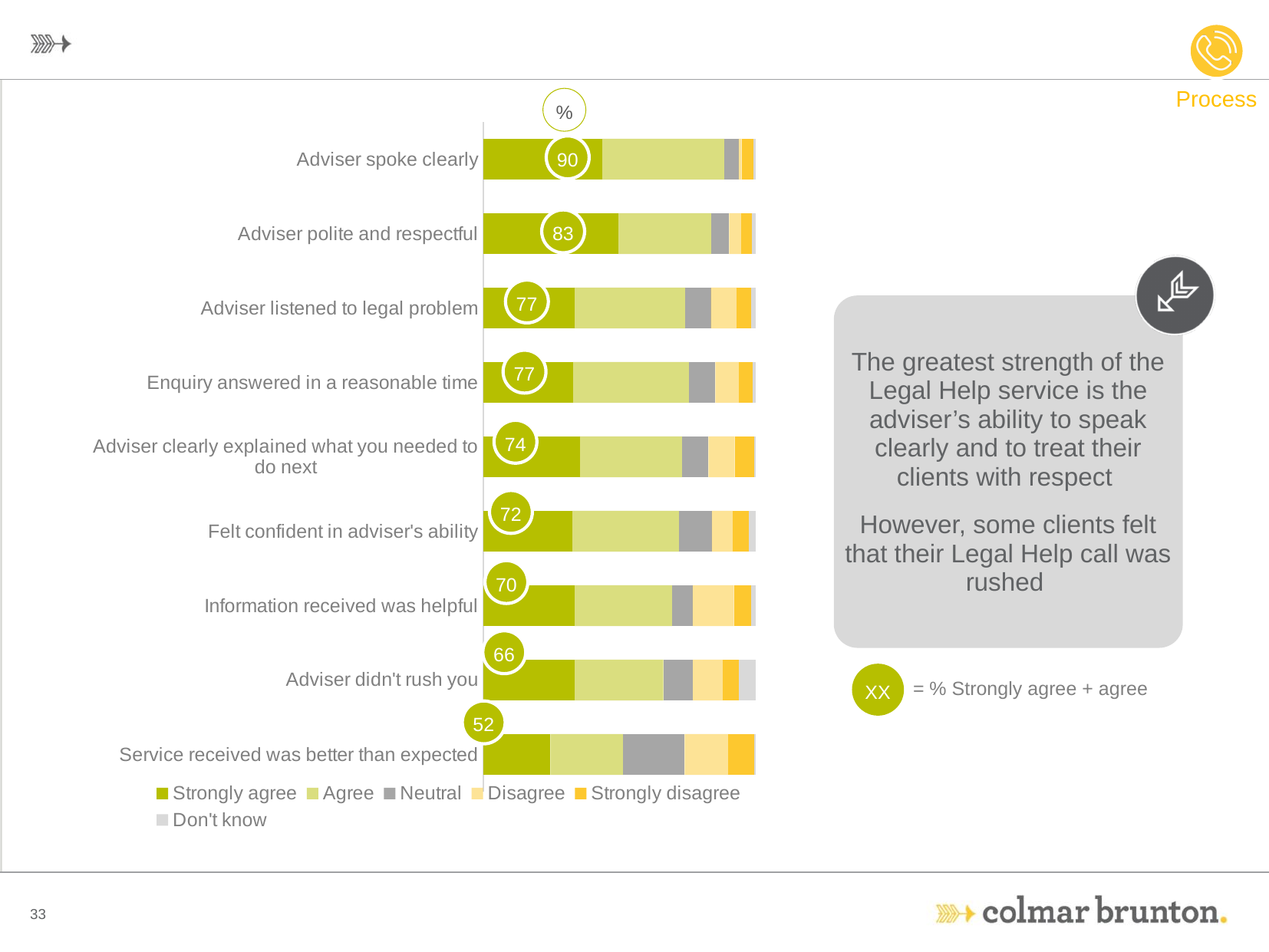
According to the key, what do the circled numbers on the bars represent? % Strongly agree + agree How many series does the legend list? 6 What is the difference between the combined agree percentages for 'Adviser spoke clearly' and 'Service received was better than expected'? 38 What is the combined percentage of strongly agree and agree for 'Adviser didn't rush you'? 66 How many statements are shown in the chart? 9 What is the combined percentage of strongly agree and agree for 'Information received was helpful'? 70 Which statement has the highest combined strongly agree + agree percentage? Adviser spoke clearly Which statement has the lowest combined strongly agree + agree percentage? Service received was better than expected Which has a higher combined agree percentage: 'Adviser clearly explained what you needed to do next' or 'Adviser didn't rush you'? Adviser clearly explained what you needed to do next What is the combined percentage of strongly agree and agree for 'Adviser spoke clearly'? 90 What is the difference between the combined agree percentages for 'Adviser polite and respectful' and 'Felt confident in adviser's ability'? 11 What kind of chart is shown on the slide? Stacked bar chart